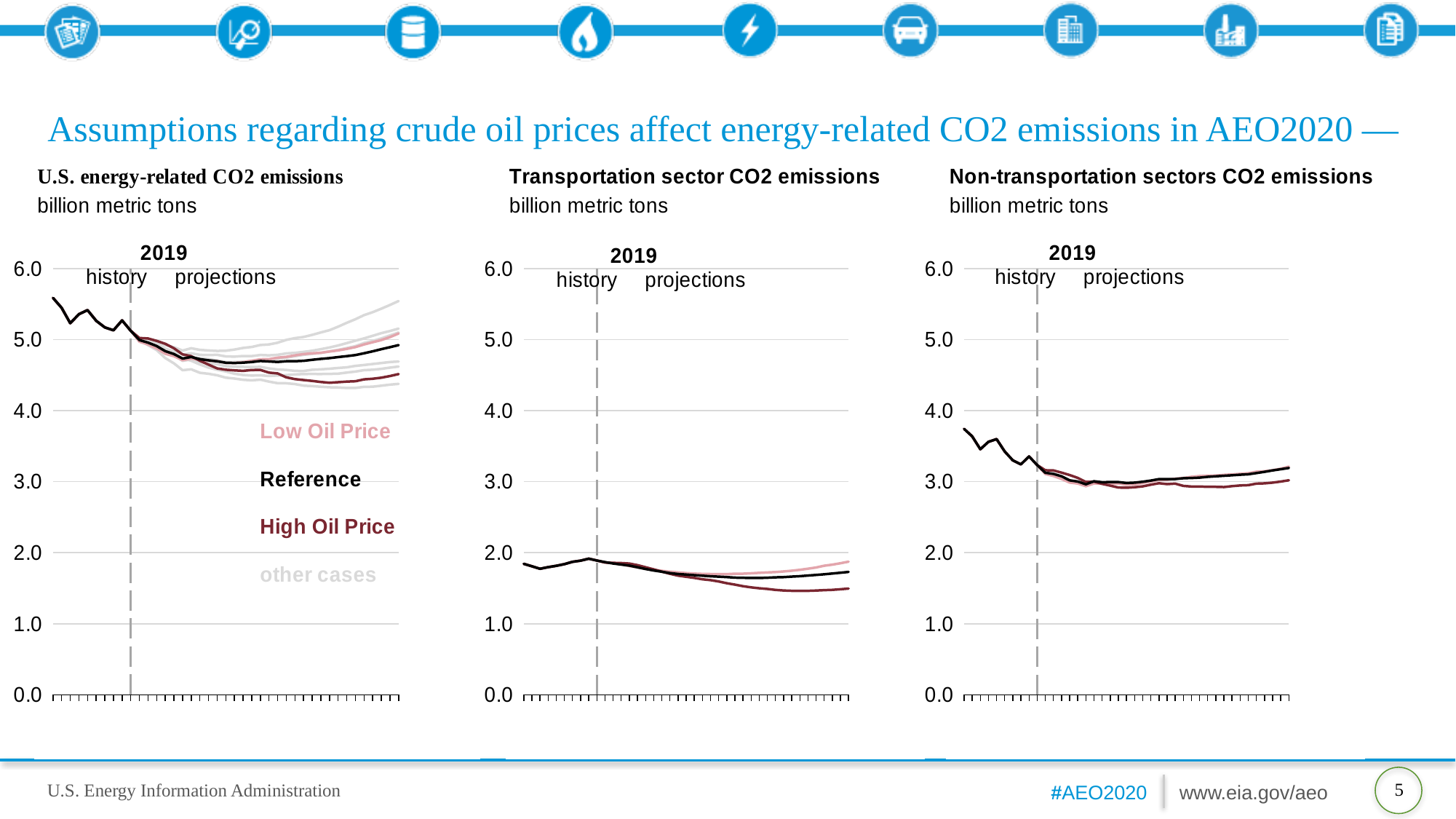
In the 'U.S. energy-related CO2 emissions' chart, at the end of the projection period, which is higher: Low Oil Price or High Oil Price? Low Oil Price In the 'Transportation sector CO2 emissions' chart, does the High Oil Price line rise or fall over the projection period? fall Which year separates history from projections in the charts? 2019 In the 'Transportation sector CO2 emissions' chart, is the Reference value at the end of the projection period greater or less than 2.0? less What unit is used on the y axis of the three charts? billion metric tons In the 'Transportation sector CO2 emissions' chart, at the end of the projection period, which is higher: Low Oil Price or High Oil Price? Low Oil Price How many entries does the legend on the 'U.S. energy-related CO2 emissions' chart list? 4 In the 'Non-transportation sectors CO2 emissions' chart, is the High Oil Price value at the end of the projection period greater or less than 4.0? less In the 'U.S. energy-related CO2 emissions' chart, is the Reference value at the end of the projection period greater or less than 4.0? greater In the 'Non-transportation sectors CO2 emissions' chart, do the values rise or fall over the history period? fall What kind of chart is the 'U.S. energy-related CO2 emissions' chart? line chart